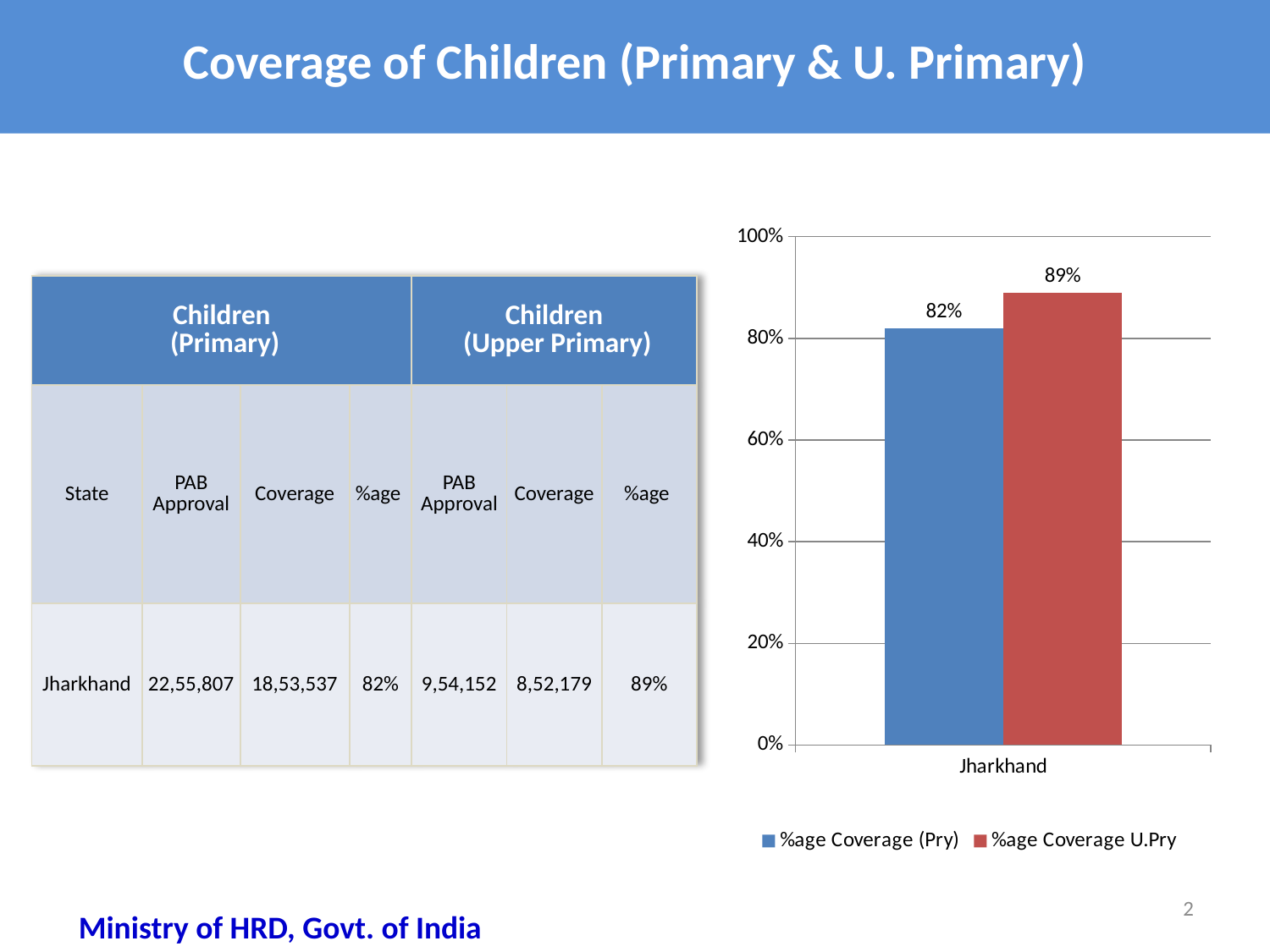
Is the value for %age Coverage U.Pry for Jharkhand greater or less than 100%? less What kind of chart is shown on the slide? Bar chart What is the value of %age Coverage (Pry) for Jharkhand? 82% Which series has the higher value for Jharkhand, %age Coverage (Pry) or %age Coverage U.Pry? %age Coverage U.Pry What colour is the bar for %age Coverage U.Pry? Red What is the highest value shown on the chart's y axis? 100% How many series does the chart legend list? 2 What is the value of %age Coverage U.Pry for Jharkhand? 89% How many categories are shown on the x axis of the chart? 1 What is the difference between %age Coverage U.Pry and %age Coverage (Pry) for Jharkhand? 7% Is the value for %age Coverage (Pry) for Jharkhand greater or less than 80%? greater